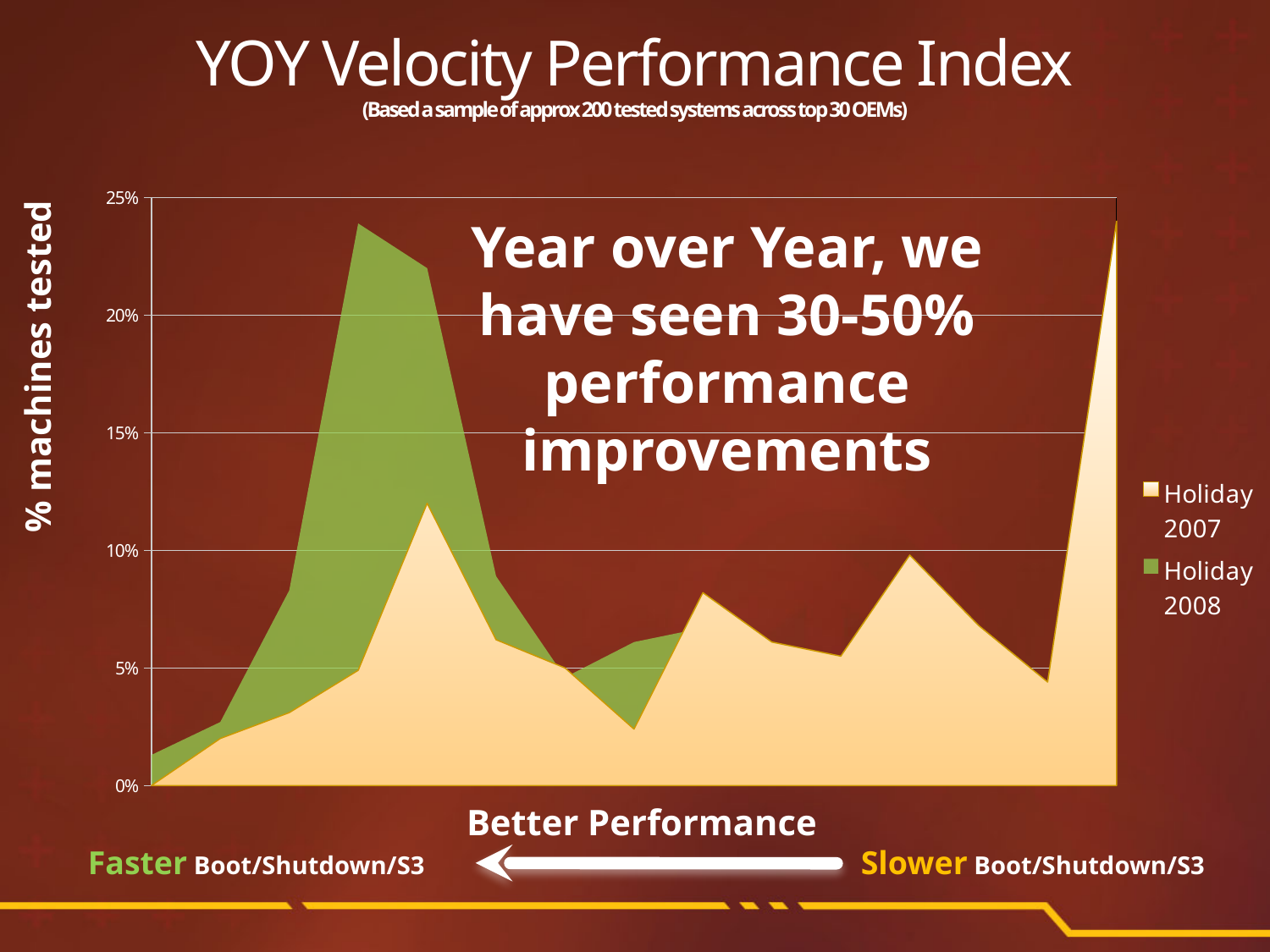
Which series has the higher value at the far left start of the chart, Holiday 2007 or Holiday 2008? Holiday 2008 Is the value at the far right end of the Holiday 2007 series greater or less than 20%? greater What kind of chart is shown on the slide? area chart Is the highest point of the Holiday 2008 series greater or less than 20%? greater Is the value at the far left start of the Holiday 2007 series greater or less than 5%? less What is the title of the chart? YOY Velocity Performance Index What is the highest value shown on the vertical axis? 25% How many series does the legend list? 2 Which series has the higher value at the far right end of the chart, Holiday 2007 or Holiday 2008? Holiday 2007 What are the two series named in the legend? Holiday 2007 and Holiday 2008